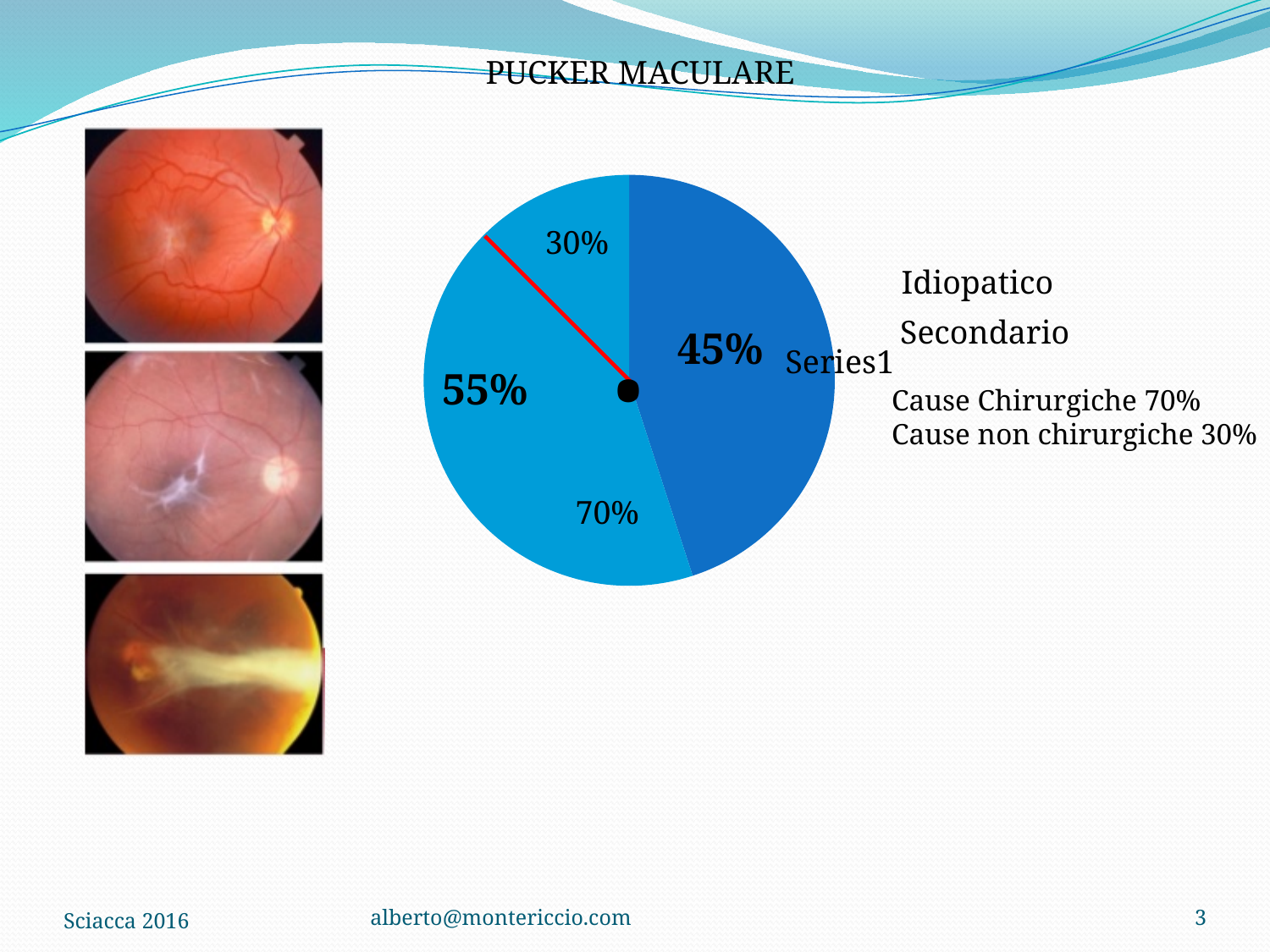
What kind of chart is shown on the slide? pie chart How many main slices does the pie chart have? 2 What is the difference between the 70% and 30% sub-parts shown in the light blue slice? 40% What is the value printed on the dark blue slice of the pie chart? 45% What series name is printed next to the pie chart? Series1 According to the text next to the pie chart, what percentage is given for 'Cause Chirurgiche'? 70% According to the text next to the pie chart, what percentage is given for 'Cause non chirurgiche'? 30% What is the value printed on the larger (light blue) slice of the pie chart? 55% What is the difference between the two main slices of the pie chart (55% and 45%)? 10% What is the title shown at the top of the slide above the pie chart? PUCKER MACULARE Which slice of the pie chart is larger, the 45% slice or the 55% slice? the 55% slice Within the light blue slice, which sub-part is larger: the 70% part or the 30% part? the 70% part